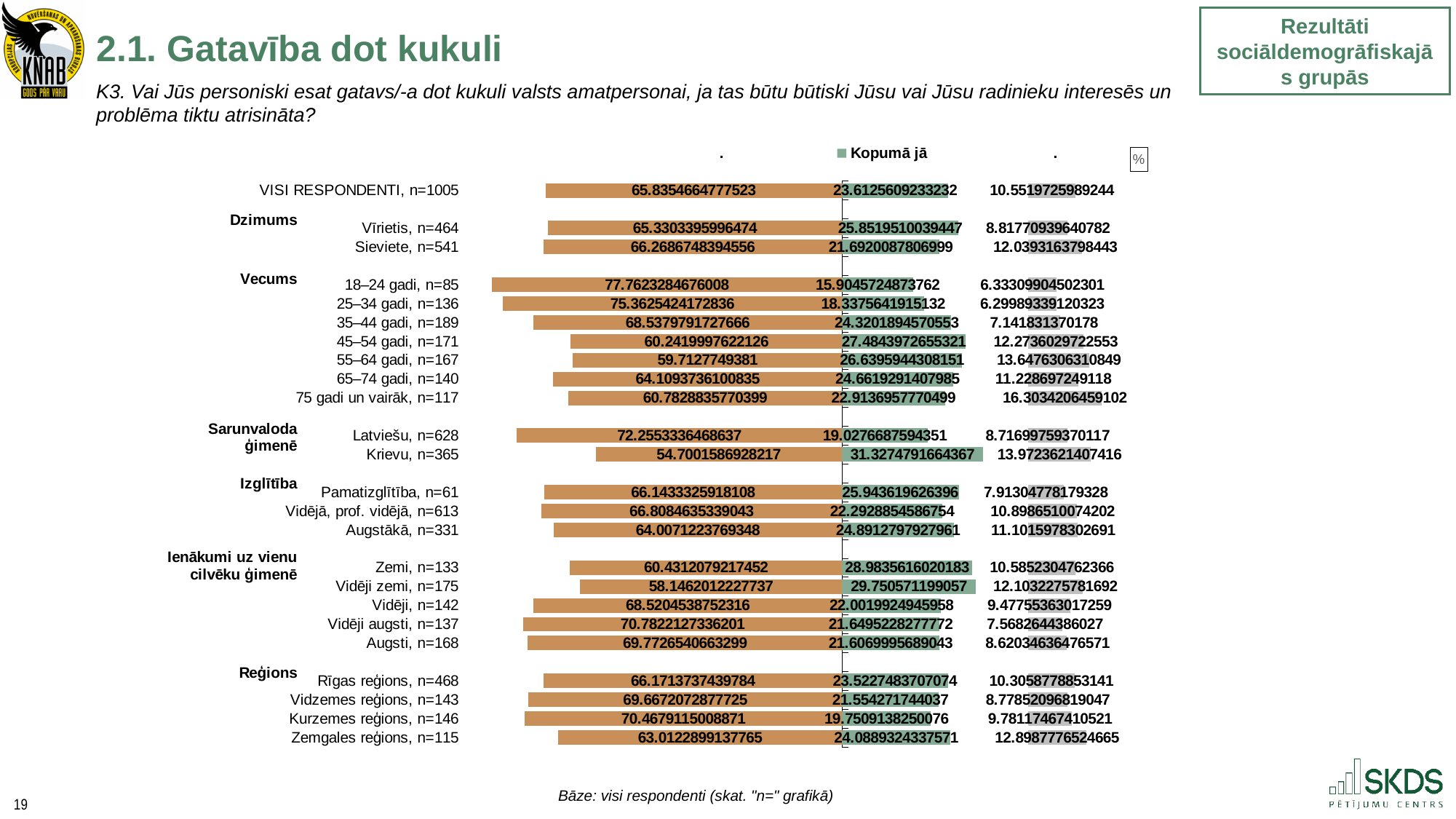
Which category has the lowest "Kopumā jā" value? 18–24 gadi, n=85 Which category has the highest "Kopumā jā" value? Krievu, n=365 What is the "Kopumā jā" value for VISI RESPONDENTI, n=1005? 23.6125609233232 What is the "Kopumā jā" value for Zemgales reģions, n=115? 24.0889324337571 What is the "Kopumā jā" value for Krievu, n=365? 31.3274791664367 How many series does the legend list? 3 How many categories (rows) are plotted in the chart? 24 Which has the larger "Kopumā jā" value, Latviešu, n=628 or Krievu, n=365? Krievu, n=365 Which series is labelled "Kopumā jā" in the legend, by colour? the green series What kind of chart is shown on the slide? bar chart What is the "Kopumā jā" value for 18–24 gadi, n=85? 15.9045724873762 Which has the larger "Kopumā jā" value, Vīrietis, n=464 or Sieviete, n=541? Vīrietis, n=464